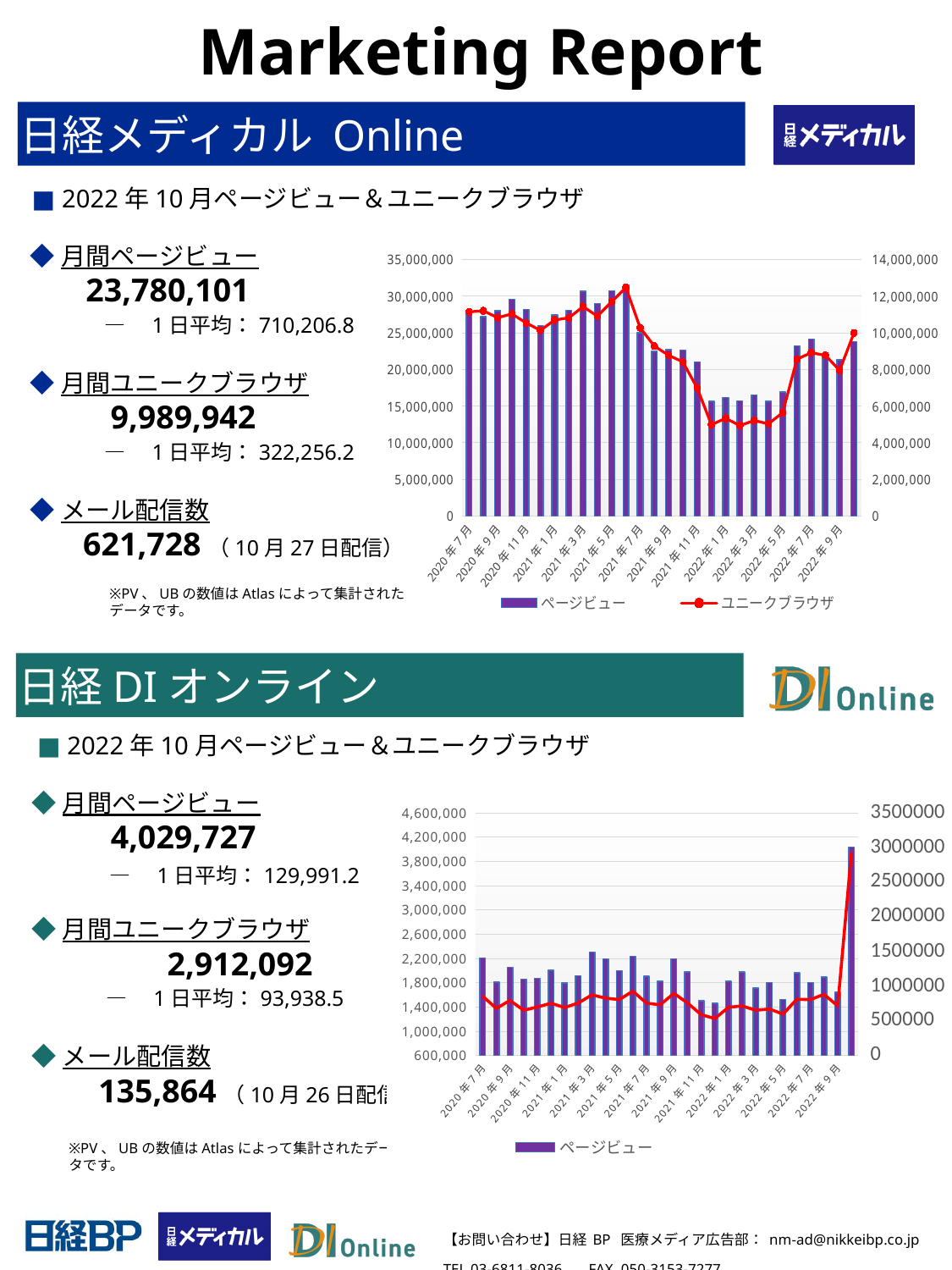
How many series does the legend of the 日経メディカル Online chart list? 2 In the 日経 DI オンライン chart, which has the larger ページビュー value, 2021年3月 or 2022年1月? 2021年3月 How many series does the legend of the 日経 DI オンライン chart list? 1 What kind of chart is the 日経メディカル Online chart? bar and line chart In the 日経メディカル Online chart, is the ユニークブラウザ value for 2022年1月 greater or less than 8,000,000 on the right axis? less In the 日経メディカル Online chart, which has the larger ページビュー value, 2021年7月 or 2022年1月? 2021年7月 What is the highest value shown on the right-hand axis of the 日経メディカル Online chart? 14,000,000 In the 日経メディカル Online chart, is the ページビュー value for 2022年3月 greater or less than 20,000,000? less In the 日経 DI オンライン chart, is the ページビュー value for 2021年3月 greater or less than 2,600,000? less What is the lowest value shown on the left-hand axis of the 日経 DI オンライン chart? 600,000 In the 日経メディカル Online chart, do the ページビュー values rise or fall from 2021年7月 to 2022年1月? fall